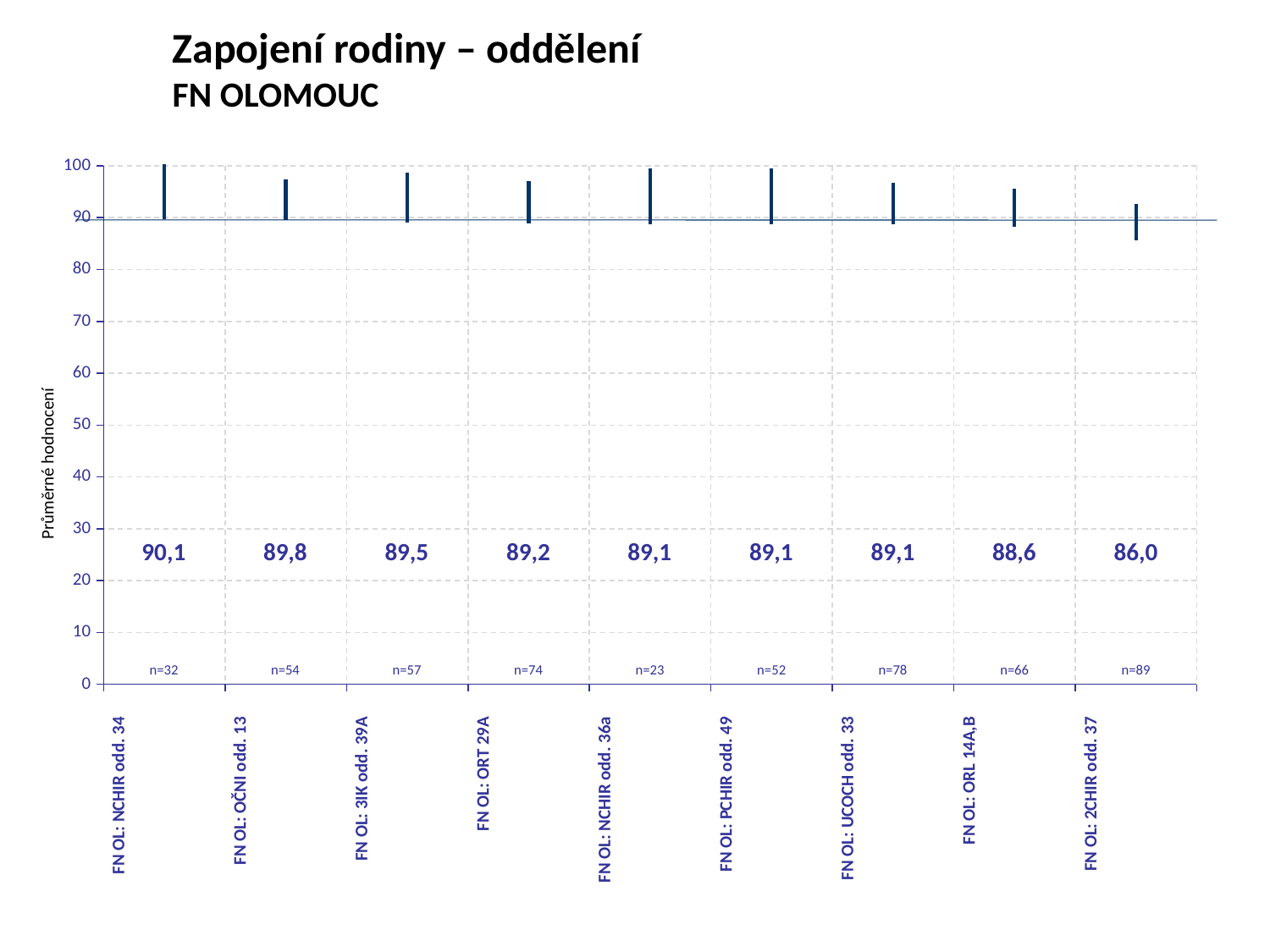
Which has a larger value, FN OL: OČNI odd. 13 or FN OL: ORL 14A,B? FN OL: OČNI odd. 13 What is the value for FN OL: ORT 29A? 89,2 What is the value for FN OL: 2CHIR odd. 37? 86,0 What is the label of the y axis? Průměrné hodnocení What is the difference between the values for FN OL: OČNI odd. 13 and FN OL: 3IK odd. 39A? 0,3 What is the value for FN OL: NCHIR odd. 34? 90,1 What is the difference between the values for FN OL: NCHIR odd. 34 and FN OL: 2CHIR odd. 37? 4,1 How many departments are shown on the x axis? 9 Which department has the lowest value? FN OL: 2CHIR odd. 37 What is the n value shown for FN OL: ORT 29A? n=74 Which department has the highest value? FN OL: NCHIR odd. 34 Do the values rise or fall from left to right along the x axis? fall